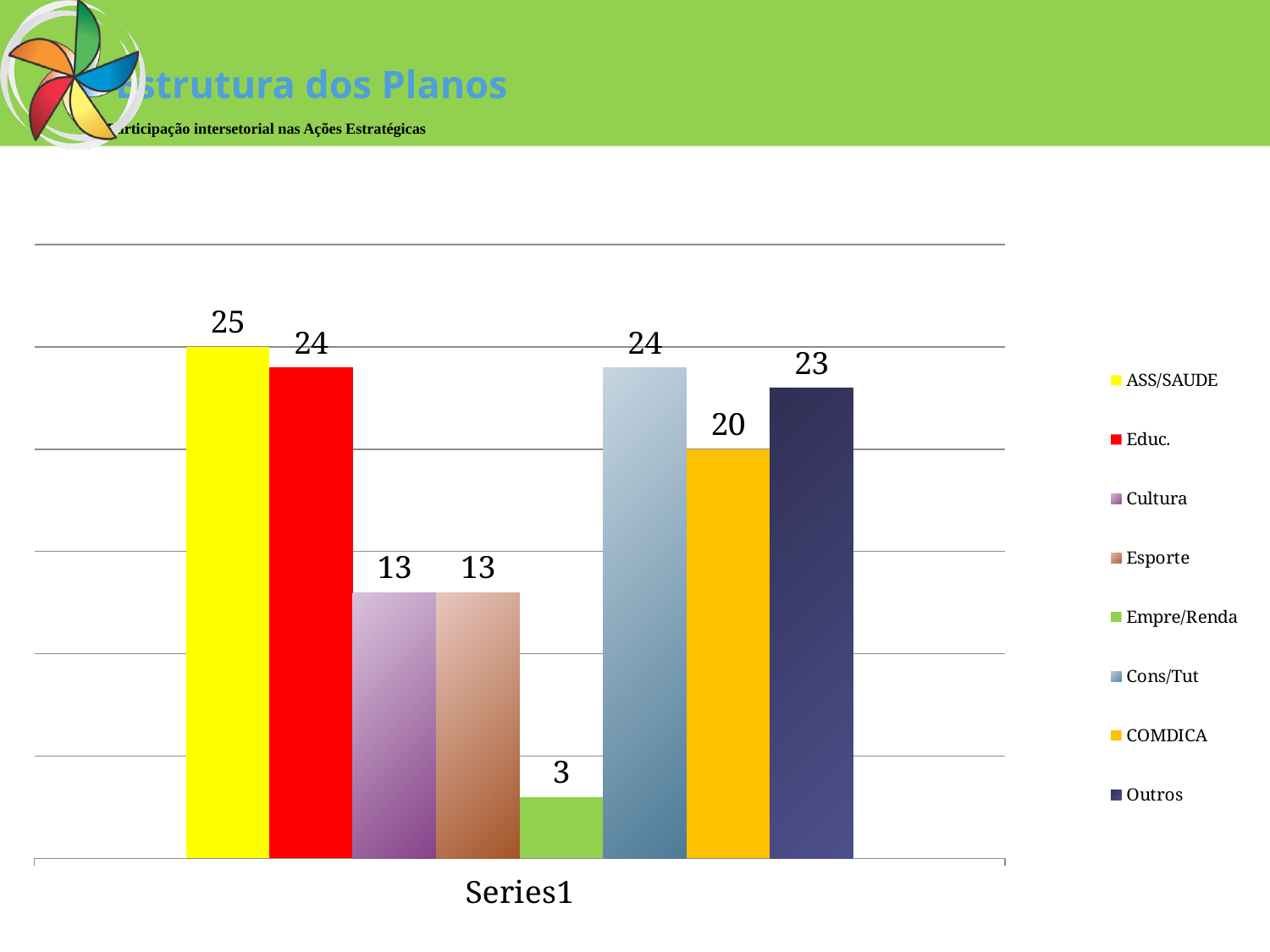
What kind of chart is shown on the slide? Bar chart Which is larger, the value for Outros or the value for COMDICA? Outros What is the value for ASS/SAUDE? 25 What is the difference between the values for Cons/Tut and COMDICA? 4 What colour is the bar for Educ.? Red Which series has the lowest value? Empre/Renda What is the value for Outros? 23 What is the value for COMDICA? 20 How many series does the legend list? 8 What is the value for Empre/Renda? 3 What is the difference between the values for ASS/SAUDE and Empre/Renda? 22 Which series has the highest value? ASS/SAUDE